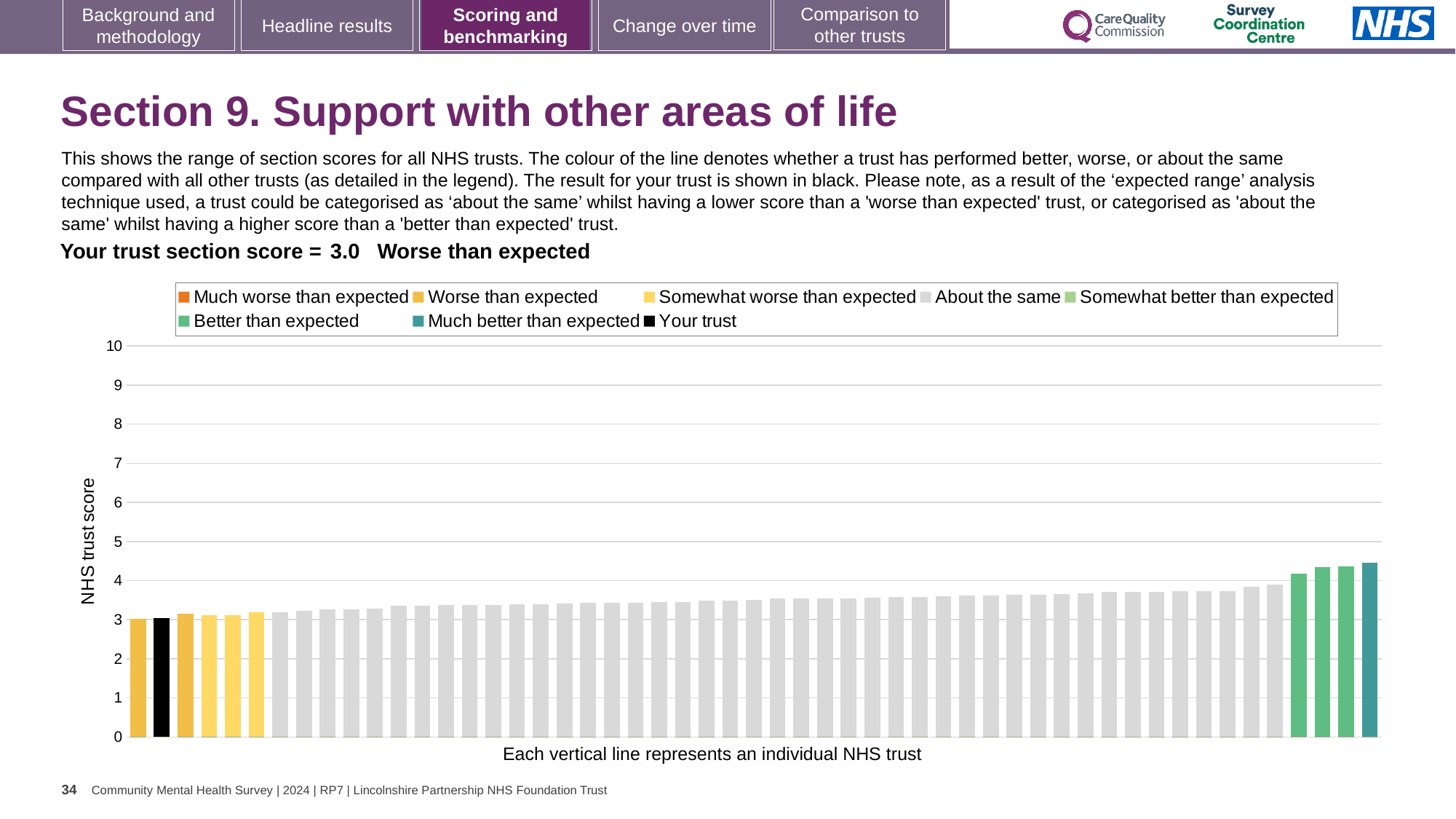
Is the value of the shortest bar greater or less than 2? greater Do the bar values rise or fall from left to right along the x axis? rise What kind of chart is shown on the slide? bar chart Which performance category is your trust's section score labelled as? Worse than expected Is the value for your trust (the black bar) greater or less than 2? greater What is the label on the y axis of the chart? NHS trust score Is the value for your trust (the black bar) greater or less than 4? less How many entries does the chart legend list? 8 What is the section score for your trust shown on the slide? 3.0